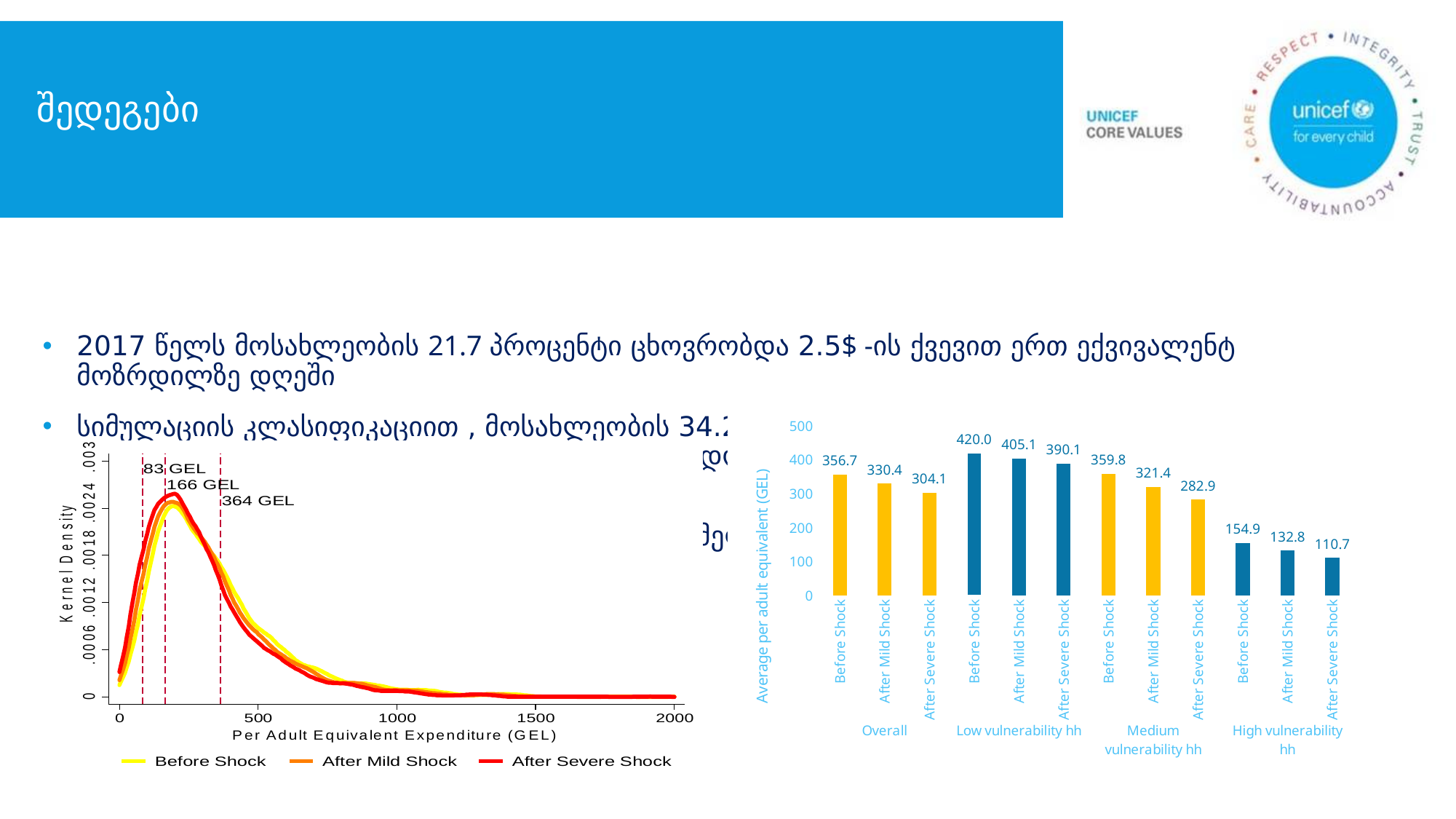
How many series does the legend of the kernel density chart on the left list? 3 In the bar chart on the right, what is the value for After Severe Shock among High vulnerability hh? 110.7 What is the x-axis label of the chart on the left? Per Adult Equivalent Expenditure (GEL) In the bar chart on the right, what is the value for After Mild Shock among Medium vulnerability hh? 321.4 In the bar chart on the right, which bar has the lowest value? After Severe Shock, High vulnerability hh (110.7) In the bar chart on the right, what is the difference between Before Shock and After Severe Shock in the Overall group? 52.6 In the bar chart on the right, which is larger: After Severe Shock for Low vulnerability hh or Before Shock for Medium vulnerability hh? After Severe Shock for Low vulnerability hh In the bar chart on the right, what is the difference between Before Shock and After Severe Shock among High vulnerability hh? 44.2 In the bar chart on the right, what is the value for Before Shock in the Overall group? 356.7 In the bar chart on the right, which bar has the highest value? Before Shock, Low vulnerability hh (420.0) How many bars are plotted in the bar chart on the right? 12 In the bar chart on the right, do the values rise or fall from Before Shock to After Severe Shock within each group? fall